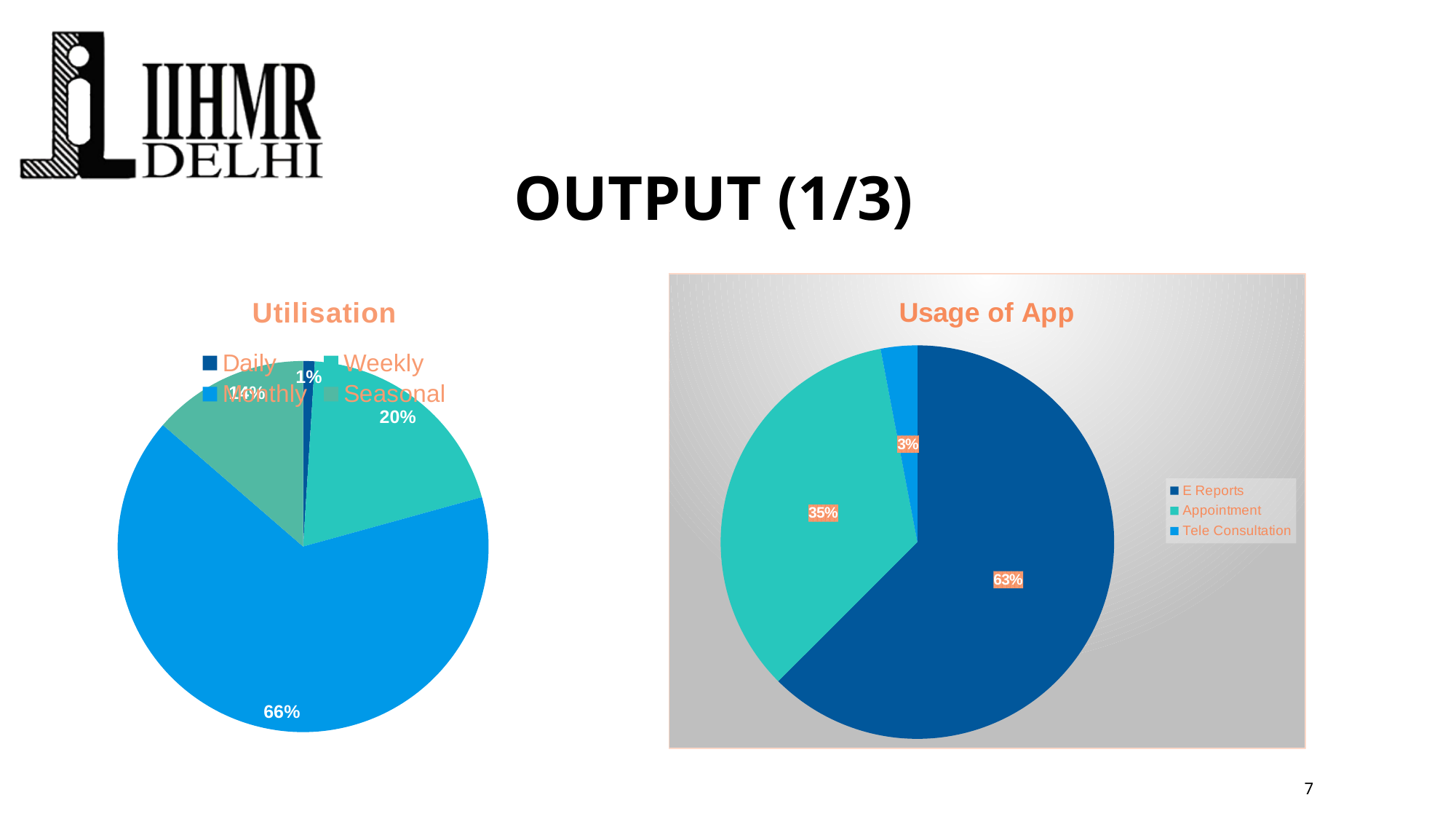
In the 'Utilisation' chart, which category has the largest share? Monthly In the 'Utilisation' chart, what percentage is shown for Monthly? 66% In the 'Usage of App' chart, what is the difference in percentage points between E Reports and Appointment? 28 In the 'Usage of App' chart, what percentage is shown for Tele Consultation? 3% In the 'Usage of App' chart, what percentage is shown for E Reports? 63% In the 'Usage of App' chart, which category has the smallest share? Tele Consultation In the 'Utilisation' chart, what percentage is shown for Weekly? 20% In the 'Usage of App' chart, which category has the largest share? E Reports In the 'Utilisation' chart, what percentage is shown for Daily? 1% What type of chart is the 'Utilisation' chart? Pie chart In the 'Usage of App' chart, how many categories does the legend list? 3 In the 'Usage of App' chart, what percentage is shown for Appointment? 35%